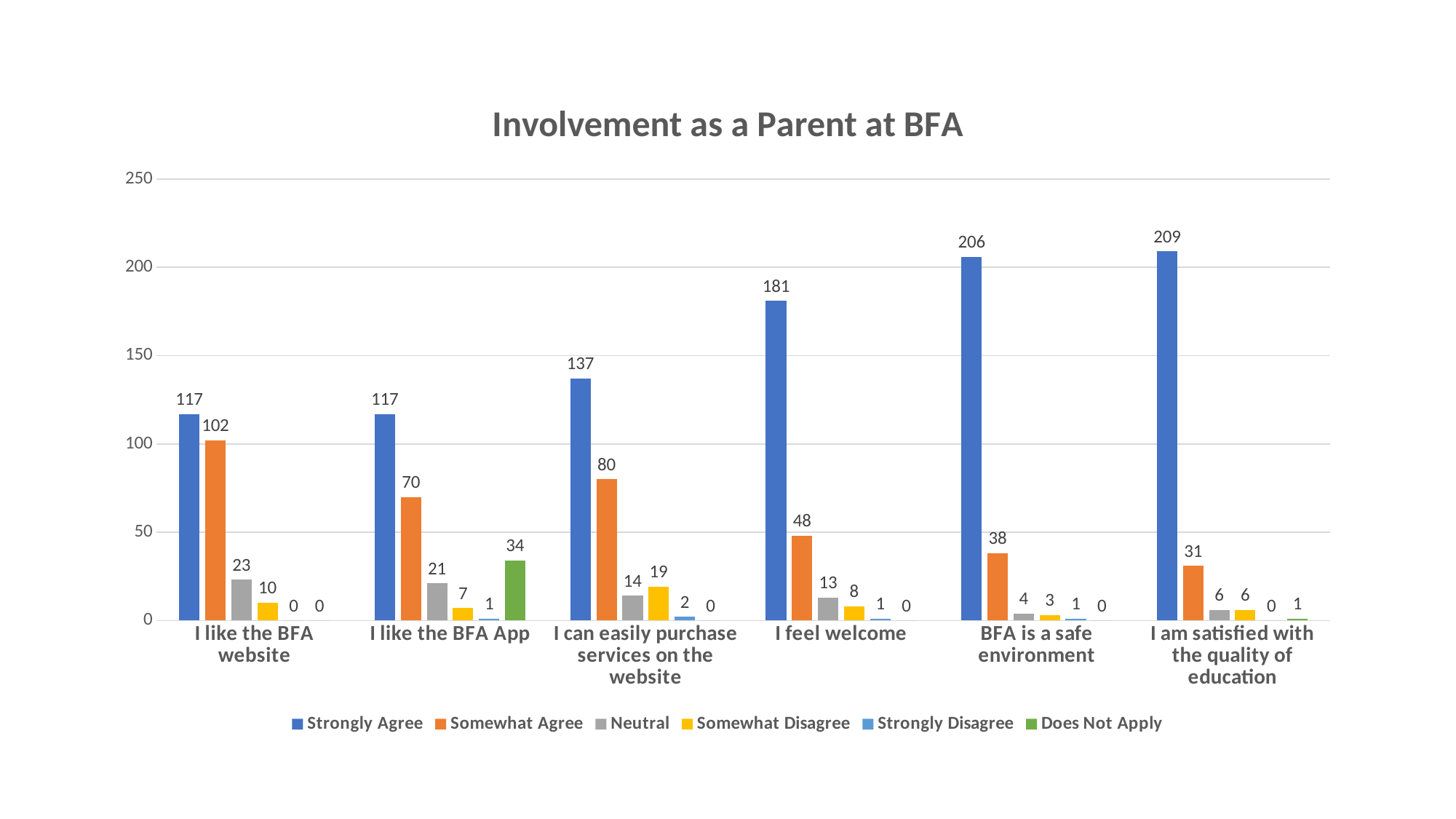
What is the Somewhat Agree value for "I like the BFA website"? 102 What is the Does Not Apply value for "I like the BFA App"? 34 What is the difference between the Strongly Agree values for "BFA is a safe environment" and "I feel welcome"? 25 What is the Strongly Agree value for "I feel welcome"? 181 How many series does the legend list? 6 What kind of chart is shown on the slide? Bar chart Which is larger: the Somewhat Agree value for "I like the BFA App" or for "I can easily purchase services on the website"? I can easily purchase services on the website What is the title of the chart? Involvement as a Parent at BFA Which category has the highest Strongly Agree value? I am satisfied with the quality of education What is the Neutral value for "BFA is a safe environment"? 4 Which category has the lowest Somewhat Agree value? I am satisfied with the quality of education How many categories are shown on the x axis? 6